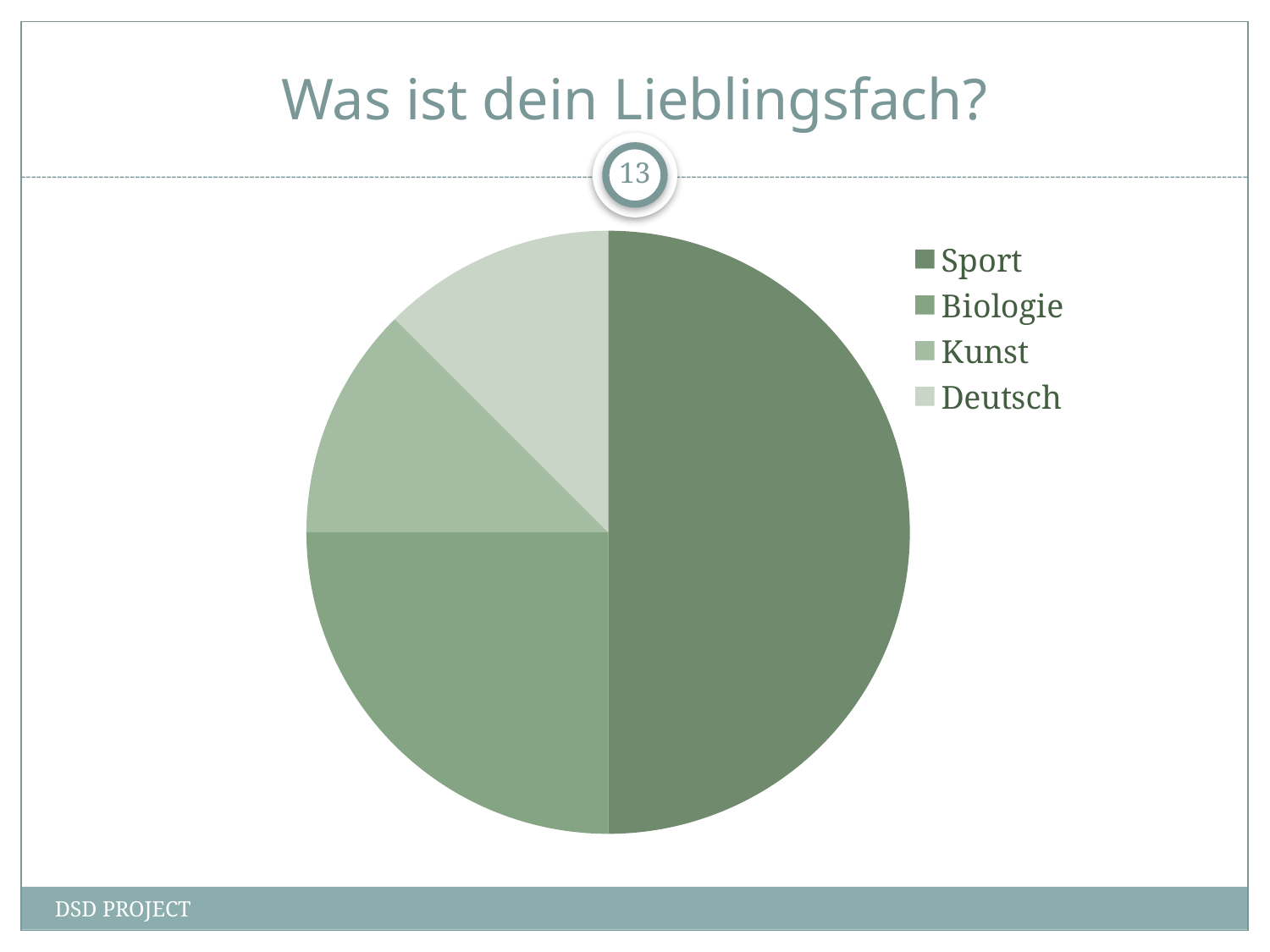
Which slice is larger, Biologie or Kunst? Biologie How many categories does the pie chart show? 4 Which slice is larger, Biologie or Deutsch? Biologie What kind of chart is shown on the slide? pie chart What is the title of the slide containing the pie chart? Was ist dein Lieblingsfach? Which category has the largest slice of the pie? Sport Which slice is larger, Sport or Biologie? Sport Which category is listed first in the legend? Sport How many entries does the legend list? 4